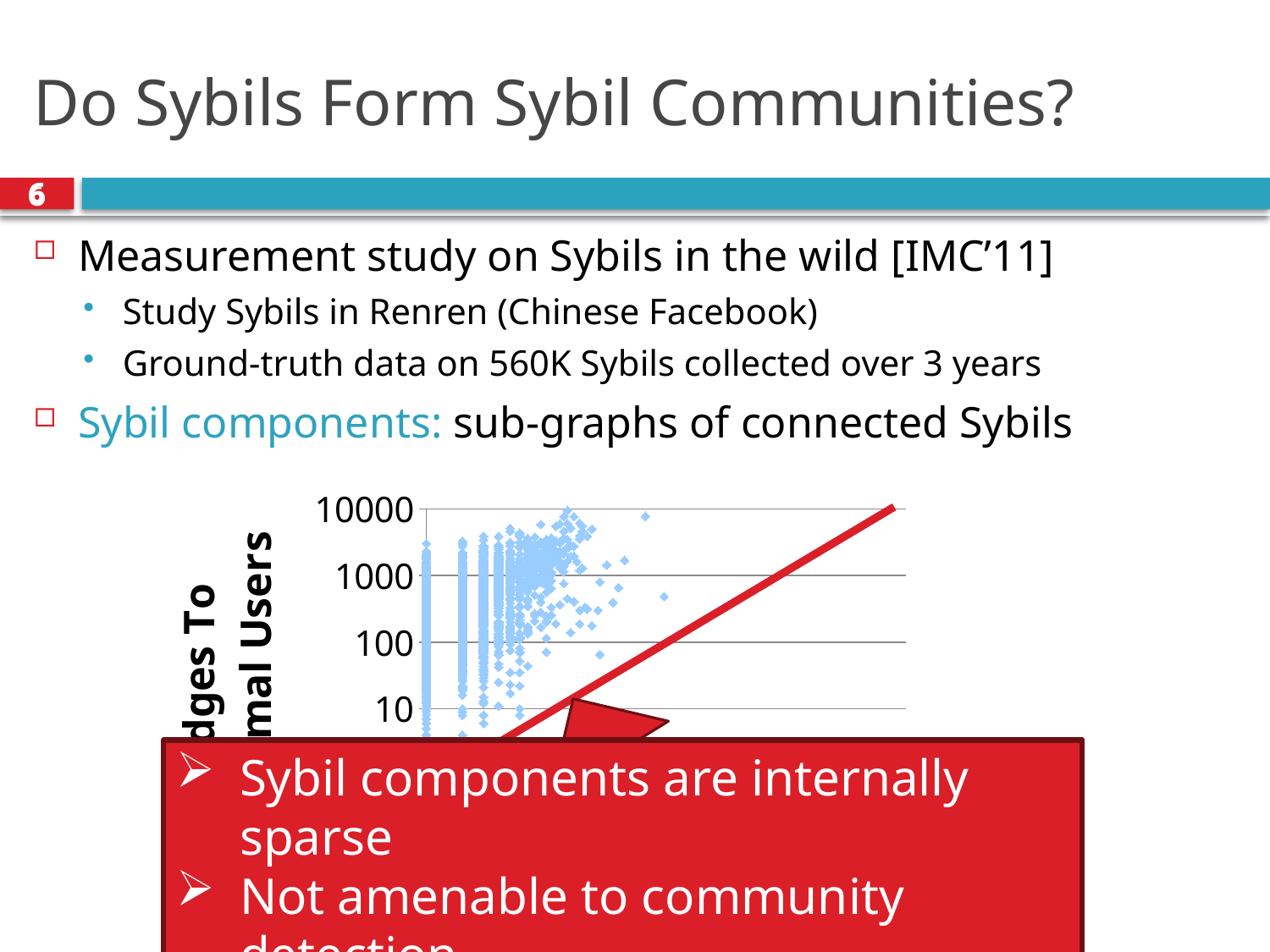
What is the highest tick label shown on the y axis of the chart? 10000 Is the highest plotted point on the chart greater or less than 1000 on the y axis? greater What colour are the plotted data points in the chart? light blue What kind of chart is shown on the slide? scatter chart